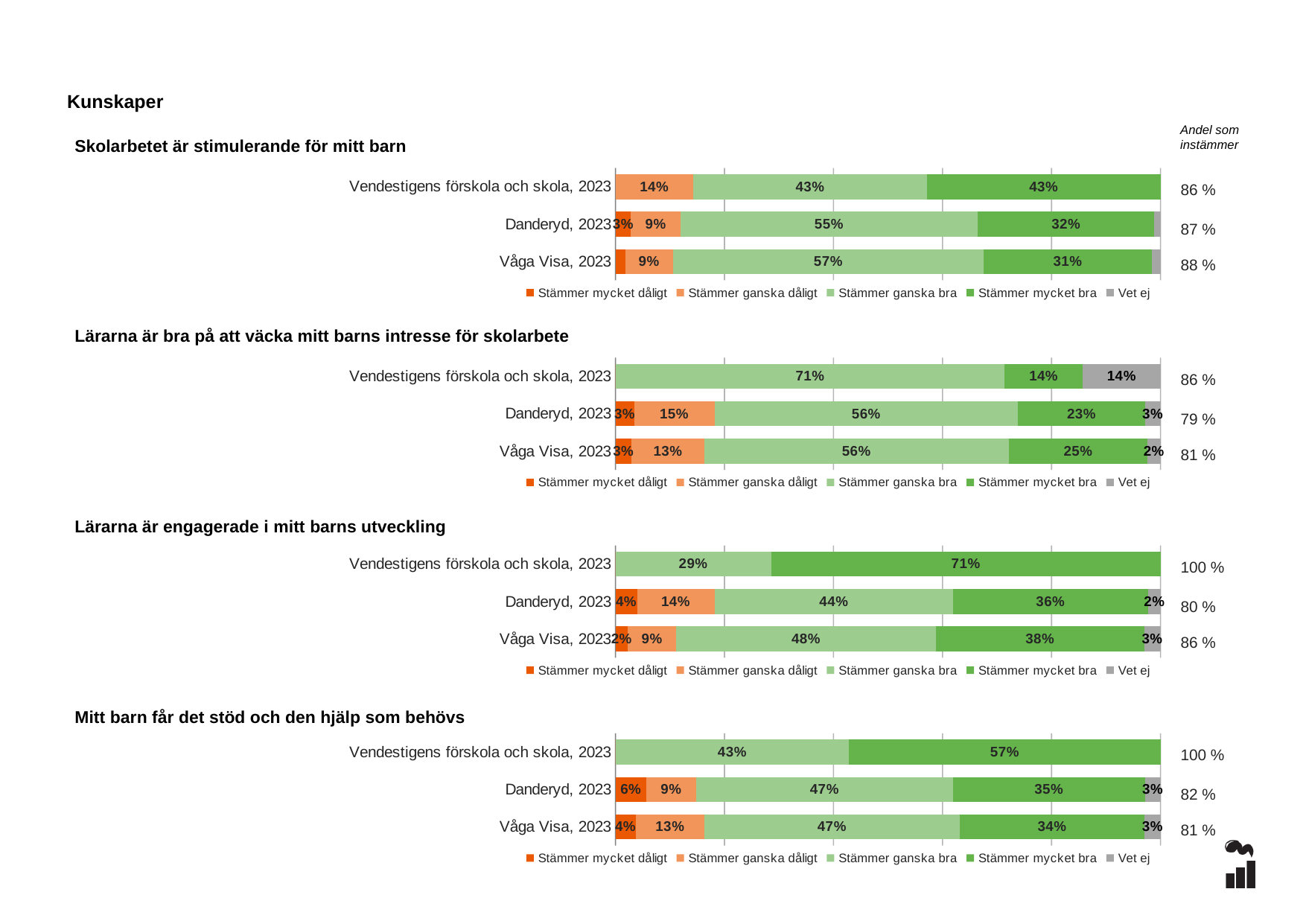
How many series does the legend list in the chart 'Skolarbetet är stimulerande för mitt barn'? 5 In the chart 'Lärarna är bra på att väcka mitt barns intresse för skolarbete', what is the 'Andel som instämmer' value shown for Danderyd, 2023? 79 % In the chart 'Lärarna är bra på att väcka mitt barns intresse för skolarbete', what is the 'Vet ej' value for Vendestigens förskola och skola, 2023? 14% In the chart 'Skolarbetet är stimulerande för mitt barn', what is the 'Stämmer mycket bra' value for Vendestigens förskola och skola, 2023? 43% How many categories are shown in the chart 'Lärarna är engagerade i mitt barns utveckling'? 3 In the chart 'Mitt barn får det stöd och den hjälp som behövs', what is the 'Stämmer ganska dåligt' value for Våga Visa, 2023? 13% In the chart 'Skolarbetet är stimulerande för mitt barn', what is the 'Stämmer ganska bra' value for Våga Visa, 2023? 57% In the chart 'Mitt barn får det stöd och den hjälp som behövs', which is larger: the 'Stämmer mycket dåligt' value for Danderyd, 2023 or for Våga Visa, 2023? Danderyd, 2023 In the chart 'Lärarna är engagerade i mitt barns utveckling', what is the difference between the 'Stämmer ganska bra' values for Våga Visa, 2023 and Danderyd, 2023? 4% In the chart 'Lärarna är bra på att väcka mitt barns intresse för skolarbete', which category has the highest 'Stämmer ganska bra' value? Vendestigens förskola och skola, 2023 In the chart 'Lärarna är engagerade i mitt barns utveckling', what is the 'Stämmer mycket bra' value for Vendestigens förskola och skola, 2023? 71% What kind of chart is 'Mitt barn får det stöd och den hjälp som behövs'? Stacked bar chart